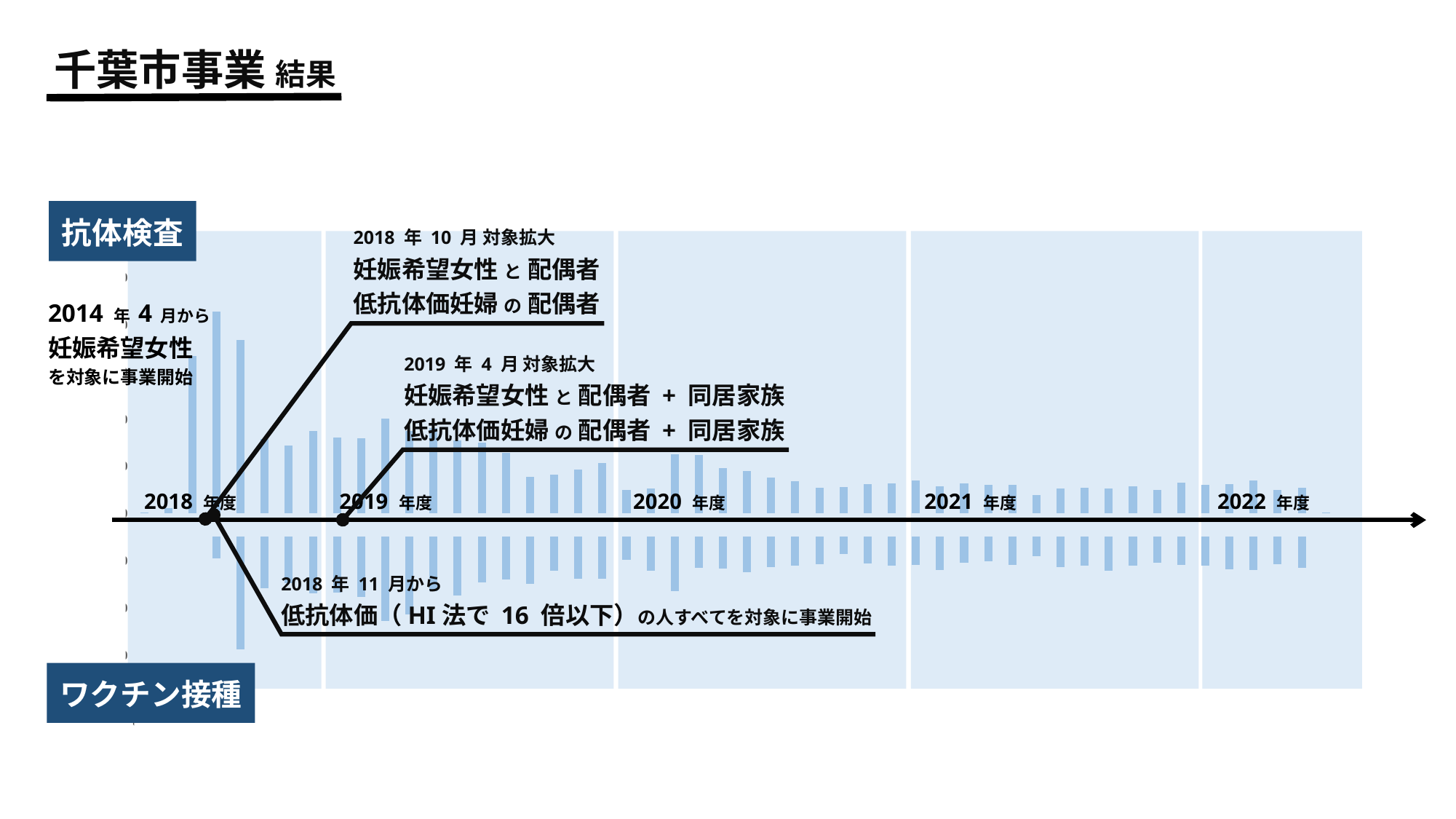
Which fiscal year label is the first one shown on the x axis? 2018年度 How many fiscal years are labeled along the x axis of the chart? 5 What do the bars above the horizontal axis represent? 抗体検査 Which fiscal year label is the last one shown on the x axis? 2022年度 What do the bars below the horizontal axis represent? ワクチン接種 Do the 抗体検査 bars generally rise or fall from 2018年度 to 2022年度? fall In which fiscal year does the longest ワクチン接種 bar appear? 2018年度 What kind of chart is shown on the slide? bar chart In which fiscal year does the tallest 抗体検査 bar appear? 2018年度 Is the tallest 抗体検査 bar in 2018年度 taller or shorter than the tallest 抗体検査 bar in 2022年度? taller How many data series does the chart show (one above and one below the axis)? 2